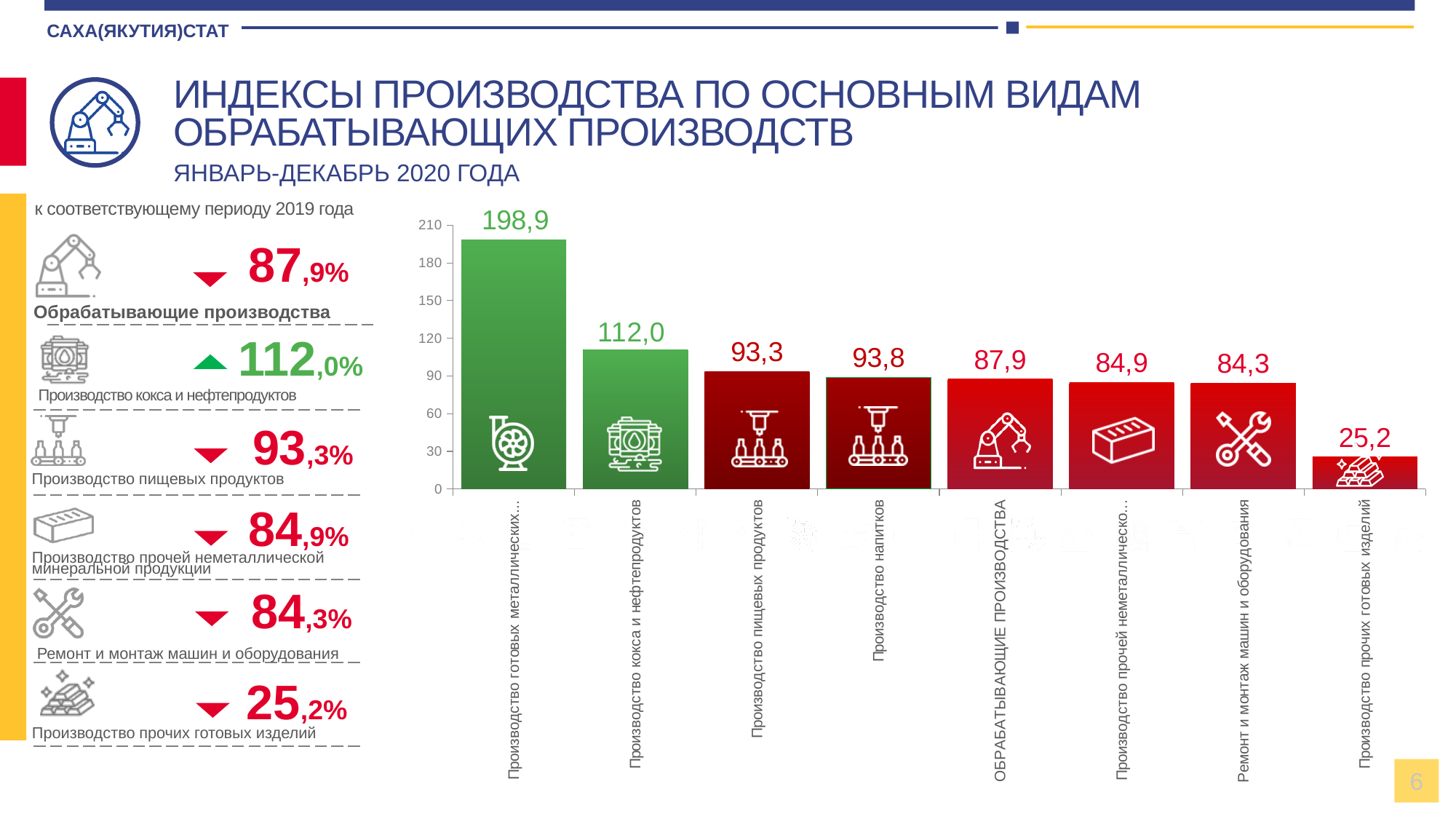
Is the value for Производство прочих готовых изделий greater or less than 30? less What is the highest value shown on the chart? 198,9 Which category has the lowest value? Производство прочих готовых изделий What is the value for ОБРАБАТЫВАЮЩИЕ ПРОИЗВОДСТВА? 87,9 What is the difference between the values for Производство кокса и нефтепродуктов and Производство прочих готовых изделий? 86,8 What is the value for Ремонт и монтаж машин и оборудования? 84,3 What colour are the bars for the two categories with values above 100? green Which is larger, the value for Производство пищевых продуктов or the value for Ремонт и монтаж машин и оборудования? Производство пищевых продуктов How many categories are shown on the chart? 8 What kind of chart is shown on the slide? bar chart What is the value for Производство кокса и нефтепродуктов? 112,0 What is the value for Производство напитков? 93,8